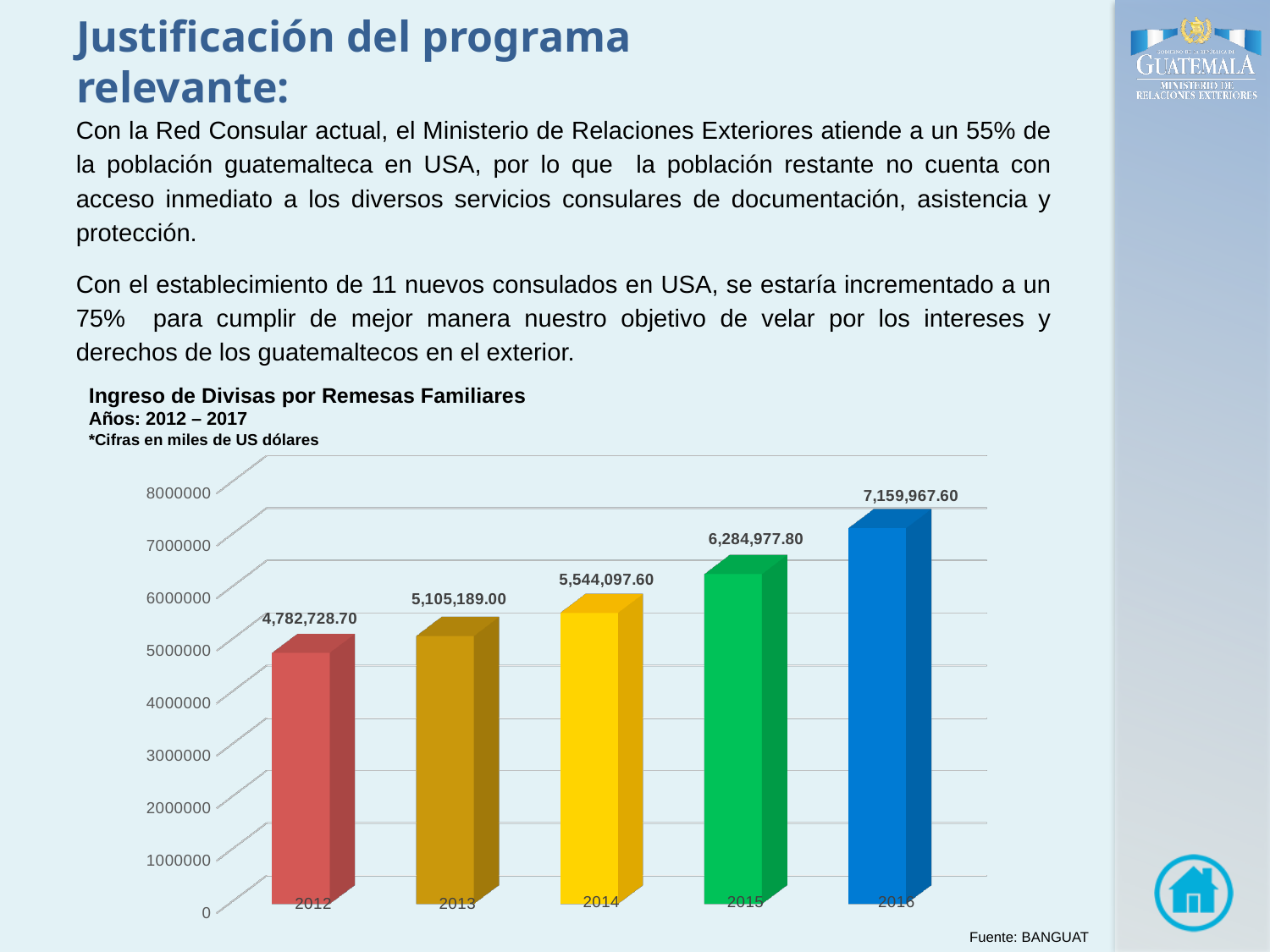
Which year has the lowest value? 2012 What is the difference between the values for 2015 and 2014? 740,880.20 Do the values rise or fall from 2012 to 2016? rise What is the value for 2012? 4,782,728.70 Which year has the highest value? 2016 How many years are shown on the chart? 5 What is the difference between the values for 2016 and 2012? 2,377,238.90 What kind of chart is shown on the slide? bar chart Is the value for 2013 greater or less than 6000000? less What is the value for 2016? 7,159,967.60 Which is larger, the value for 2013 or the value for 2015? 2015 What is the value for 2014? 5,544,097.60